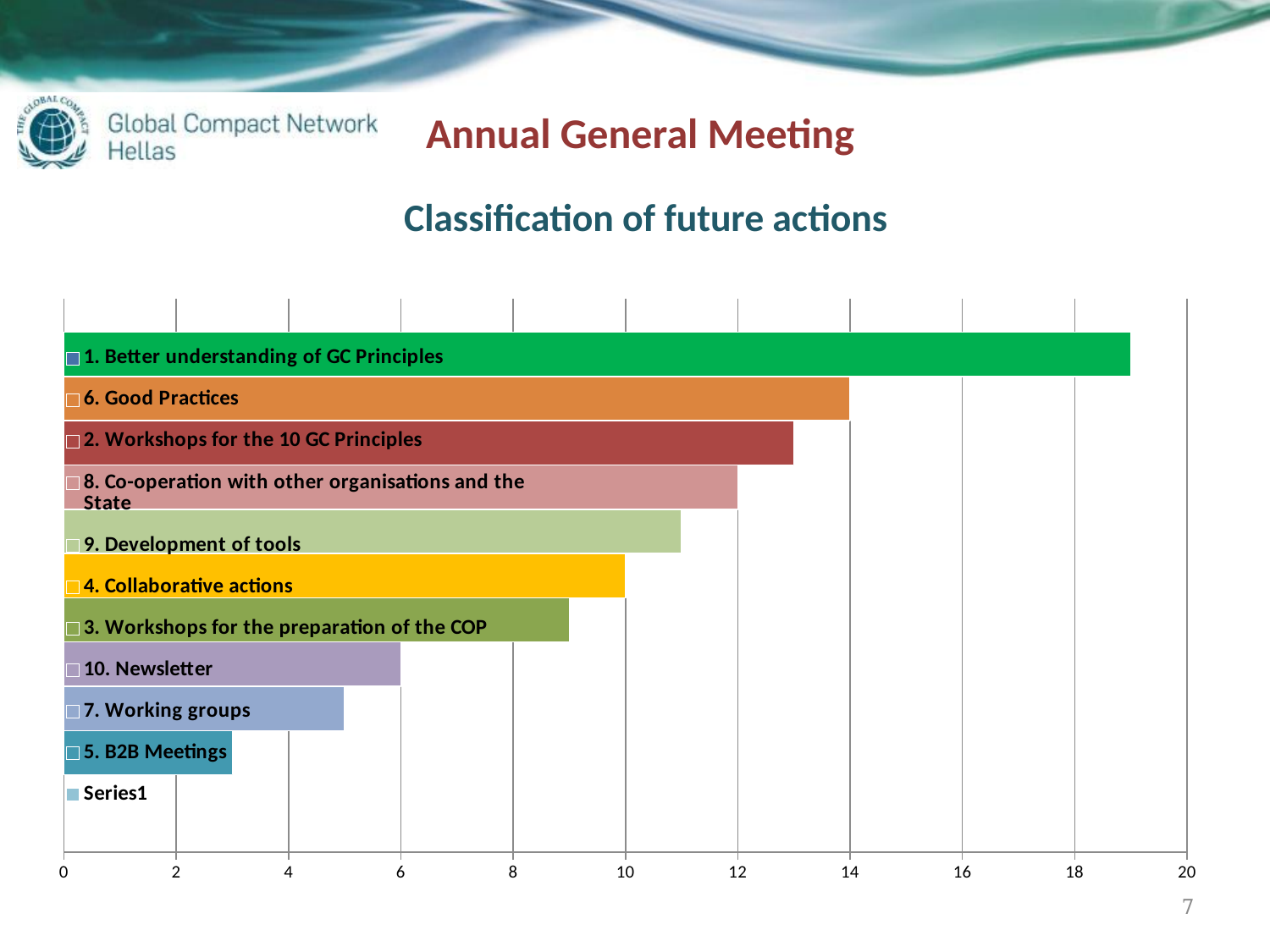
Which category has the highest value? 1. Better understanding of GC Principles Is the value for 5. B2B Meetings greater or less than 4? less What is the difference between the values for 6. Good Practices and 10. Newsletter? 8 Which category has the lowest value? 5. B2B Meetings What is the value for 8. Co-operation with other organisations and the State? 12 Which is larger, the value for 2. Workshops for the 10 GC Principles or the value for 3. Workshops for the preparation of the COP? 2. Workshops for the 10 GC Principles What is the value for 4. Collaborative actions? 10 Is the value for 1. Better understanding of GC Principles greater or less than 18? greater What type of chart is shown on the slide? bar chart How many categories are plotted in the chart? 10 What is the value for 10. Newsletter? 6 What is the value for 6. Good Practices? 14